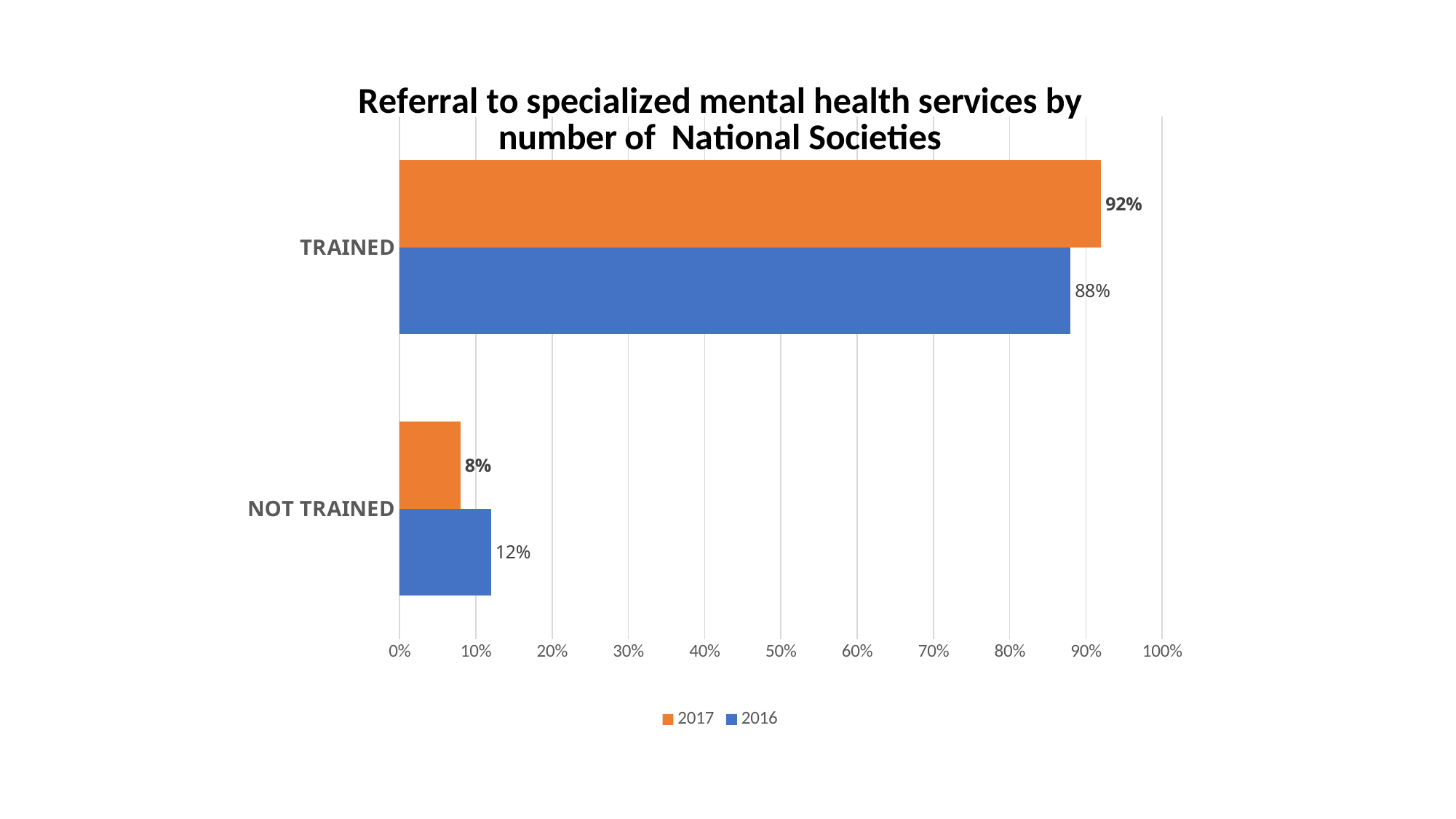
What is the value for NOT TRAINED in the 2016 series? 12% How many series does the legend list? 2 What is the value for NOT TRAINED in the 2017 series? 8% Which category has the highest value in the 2017 series? TRAINED For NOT TRAINED, which series has the larger value, 2017 or 2016? 2016 What is the difference between the 2016 and 2017 values for NOT TRAINED? 4% What is the value for TRAINED in the 2017 series? 92% How many categories are shown on the chart? 2 Which category has the lowest value in the 2016 series? NOT TRAINED What is the difference between the 2017 and 2016 values for TRAINED? 4% What is the value for TRAINED in the 2016 series? 88% What kind of chart is shown on the slide? Bar chart